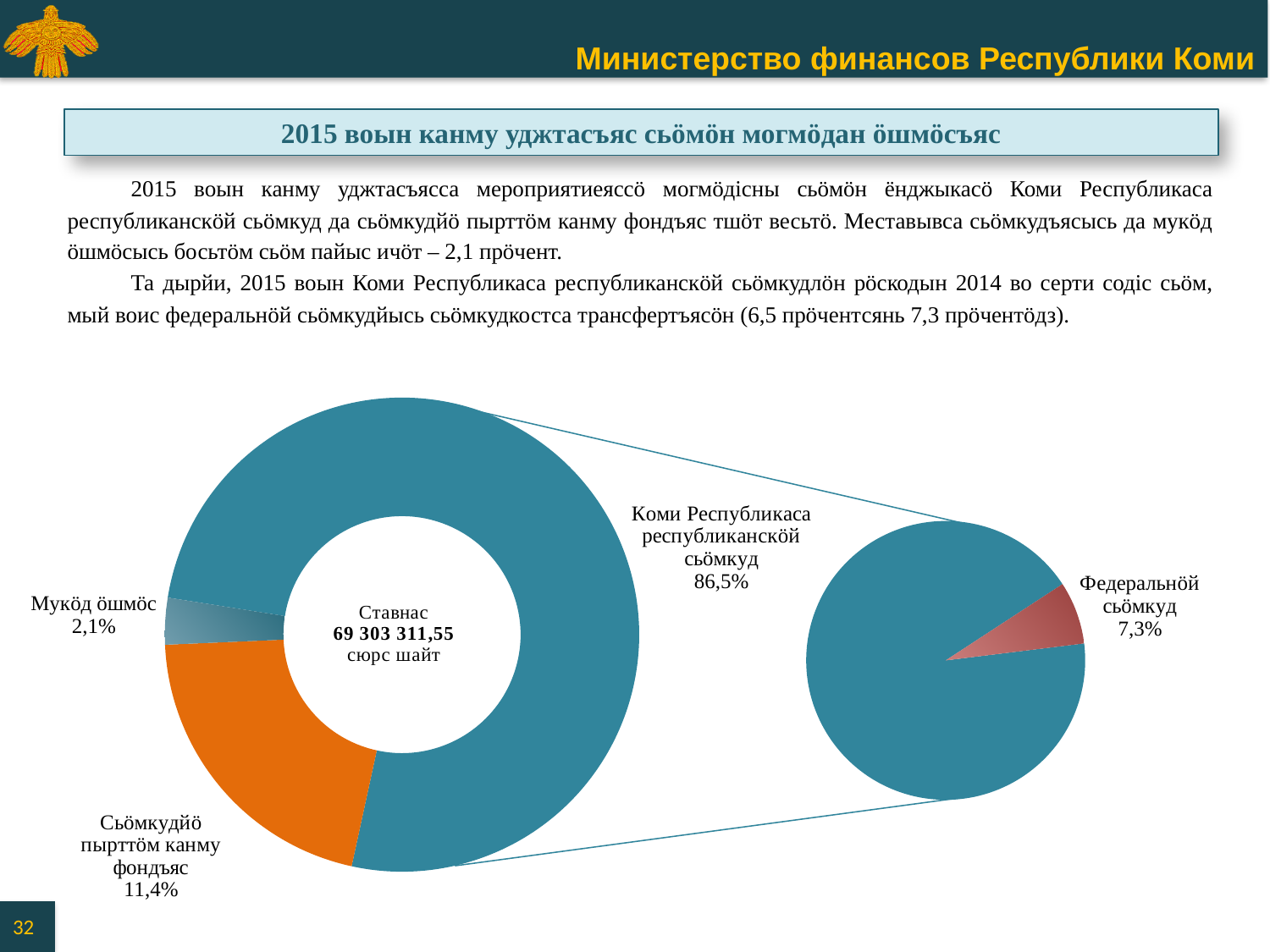
What share is shown for "Федеральнöй сьöмкуд" in the smaller pie on the right? 7,3% Which category has the largest share in the donut chart? Коми Республикаса республиканскöй сьöмкуд Which is larger: the share of "Сьöмкудйö пырттöм канму фондъяс" or the share of "Мукöд öшмöс"? Сьöмкудйö пырттöм канму фондъяс What share of the donut chart is labelled "Коми Республикаса республиканскöй сьöмкуд"? 86,5% What is the difference in percentage points between the shares of "Коми Республикаса республиканскöй сьöмкуд" and "Сьöмкудйö пырттöм канму фондъяс"? 75,1 What is the combined share of "Сьöмкудйö пырттöм канму фондъяс" and "Мукöд öшмöс" in the donut chart? 13,5% How many categories are shown in the main donut chart? 3 What share of the donut chart is labelled "Мукöд öшмöс"? 2,1% Which category has the smallest share in the donut chart? Мукöд öшмöс What share of the donut chart is labelled "Сьöмкудйö пырттöм канму фондъяс"? 11,4% What total value (Ставнас) is printed in the centre of the donut chart? 69 303 311,55 сюрс шайт What type of chart is the main chart on the slide? Donut (pie) chart